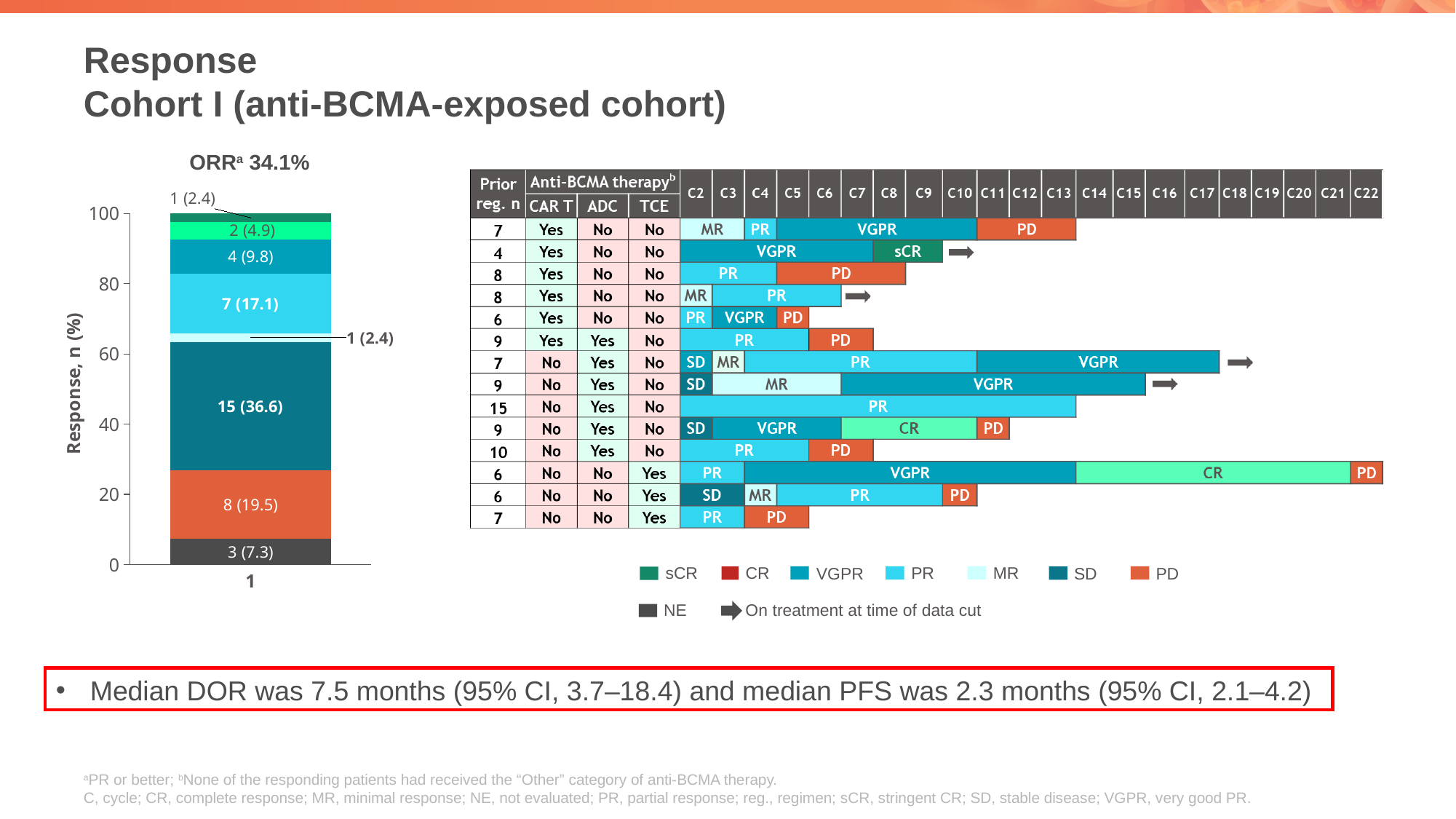
Adding the patient counts of all segments in the stacked bar, how many patients are in the cohort? 41 What ORR value is printed above the stacked bar chart? 34.1% In the stacked bar chart, how many more patients are in the 15 (36.6) segment than in the 8 (19.5) segment? 7 What kind of chart is shown on the left of the slide? Stacked bar chart What is the y-axis label of the stacked bar chart? Response, n (%) In the stacked bar chart, what is the label of the largest segment? 15 (36.6) In the stacked bar chart, what is the label of the bottom (dark gray) segment? 3 (7.3) In the swimmer plot on the right, how many patient rows are shown? 14 In the stacked bar chart, which segment is larger: 8 (19.5) or 7 (17.1)? 8 (19.5) In the stacked bar chart, what is the label of the orange segment? 8 (19.5) How many response categories does the legend list (excluding the arrow symbol)? 8 How many segments make up the stacked bar in the left chart? 8